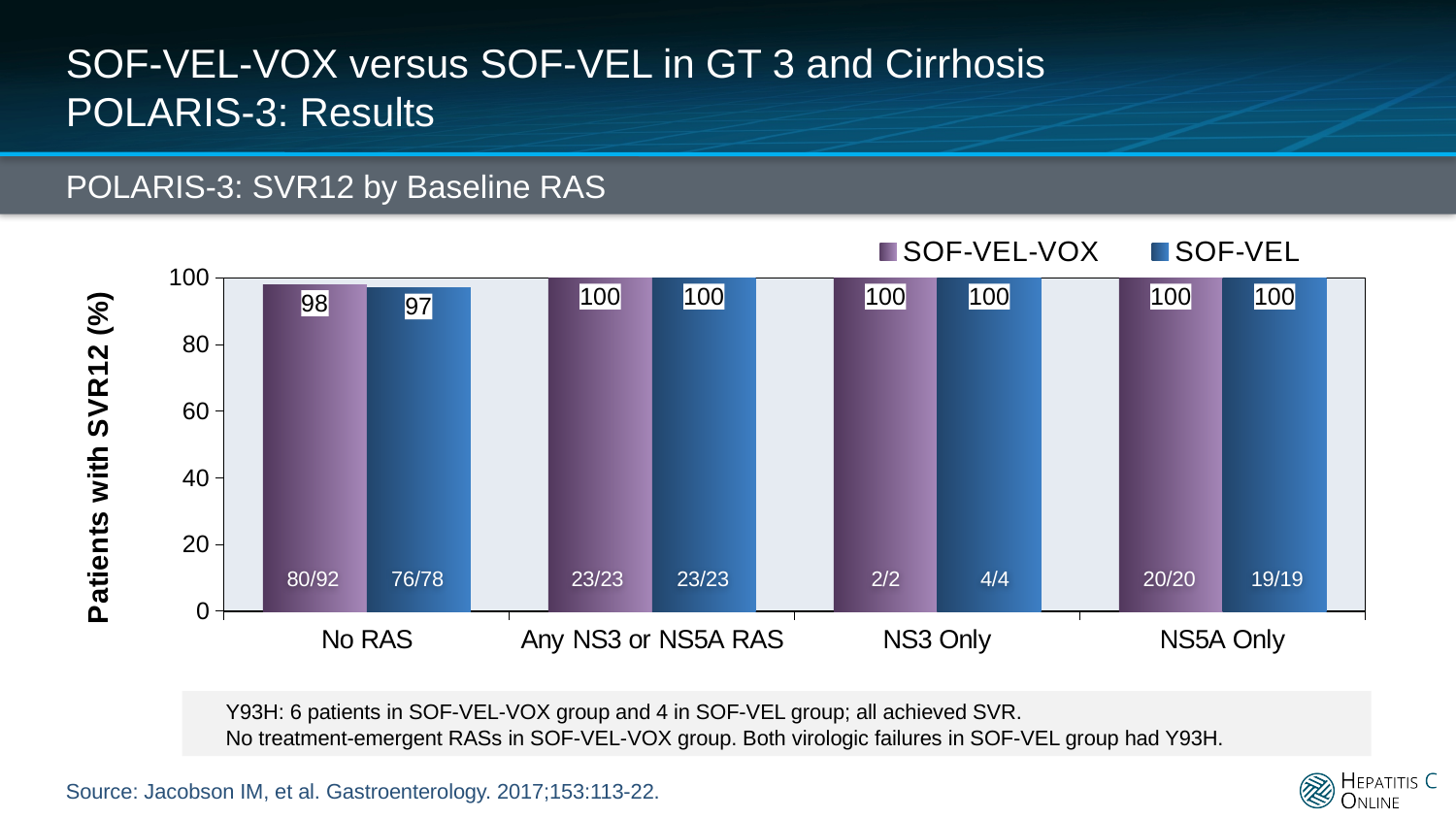
What is the patient fraction shown for SOF-VEL in the NS3 Only group? 4/4 What is the SVR12 rate for SOF-VEL in the No RAS group? 97 What is the label of the y axis? Patients with SVR12 (%) What kind of chart is shown on the slide? Bar chart Which category has the lowest SVR12 rate for SOF-VEL? No RAS What is the SVR12 rate for SOF-VEL-VOX in the No RAS group? 98 What is the SVR12 rate for SOF-VEL in the NS5A Only group? 100 What is the difference between the SOF-VEL-VOX and SOF-VEL SVR12 rates in the No RAS group? 1 How many baseline RAS categories are shown on the x axis? 4 Is the SVR12 rate for SOF-VEL-VOX in the No RAS group greater or less than 80? greater What is the patient fraction shown for SOF-VEL-VOX in the No RAS group? 80/92 How many series does the legend list? 2